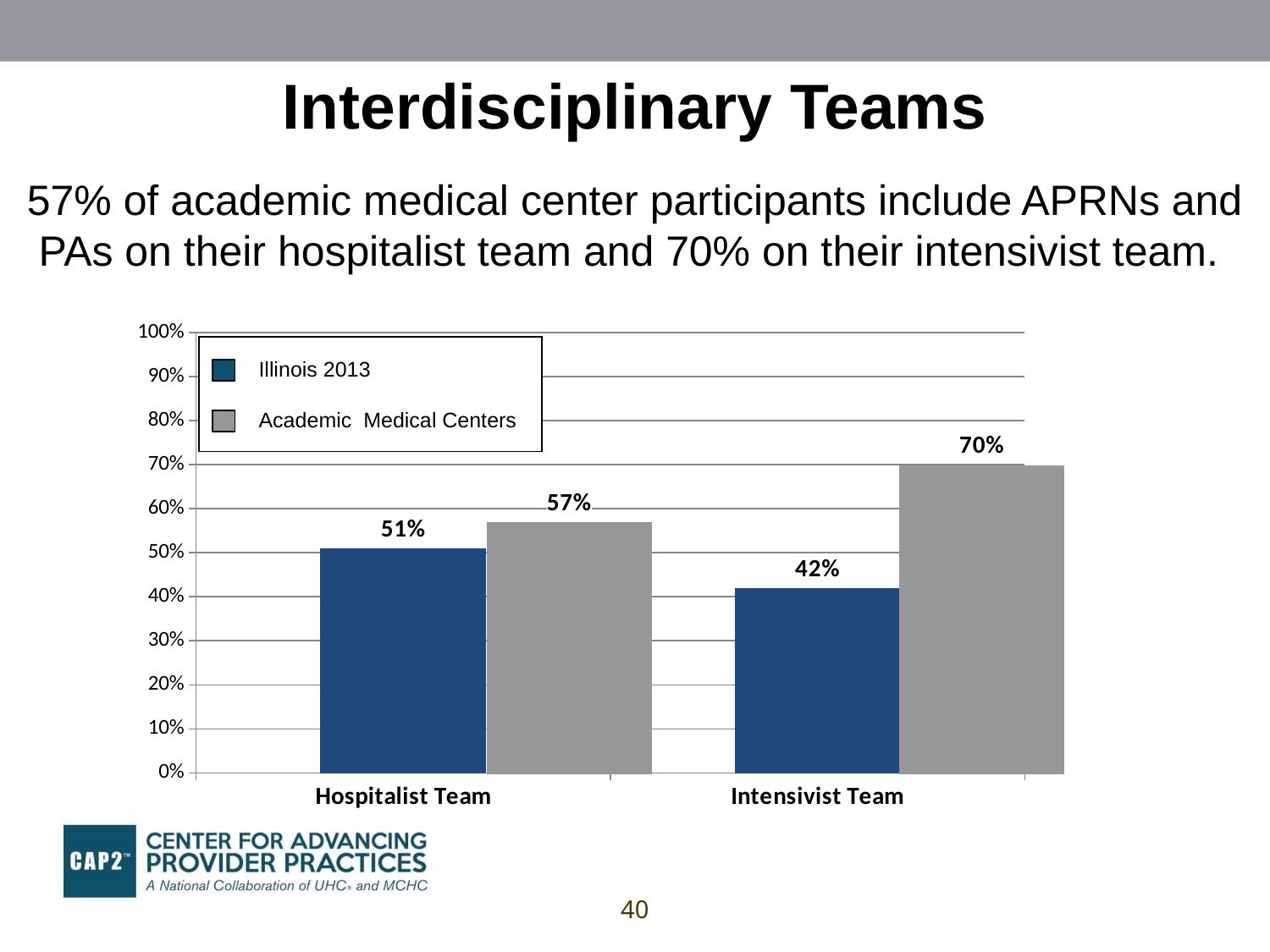
What is the difference between the Academic Medical Centers and Illinois 2013 values for the Intensivist Team? 28% How many categories are shown on the x axis of the chart? 2 What is the value for Illinois 2013 on the Hospitalist Team? 51% Which bar in the chart has the lowest value? Illinois 2013, Intensivist Team What kind of chart is shown on the slide? Bar chart What is the value for Academic Medical Centers on the Intensivist Team? 70% Which is larger for Illinois 2013: the Hospitalist Team value or the Intensivist Team value? Hospitalist Team How many series does the legend list? 2 Which bar in the chart has the highest value? Academic Medical Centers, Intensivist Team What is the difference between the Academic Medical Centers and Illinois 2013 values for the Hospitalist Team? 6% What is the value for Illinois 2013 on the Intensivist Team? 42% What is the value for Academic Medical Centers on the Hospitalist Team? 57%